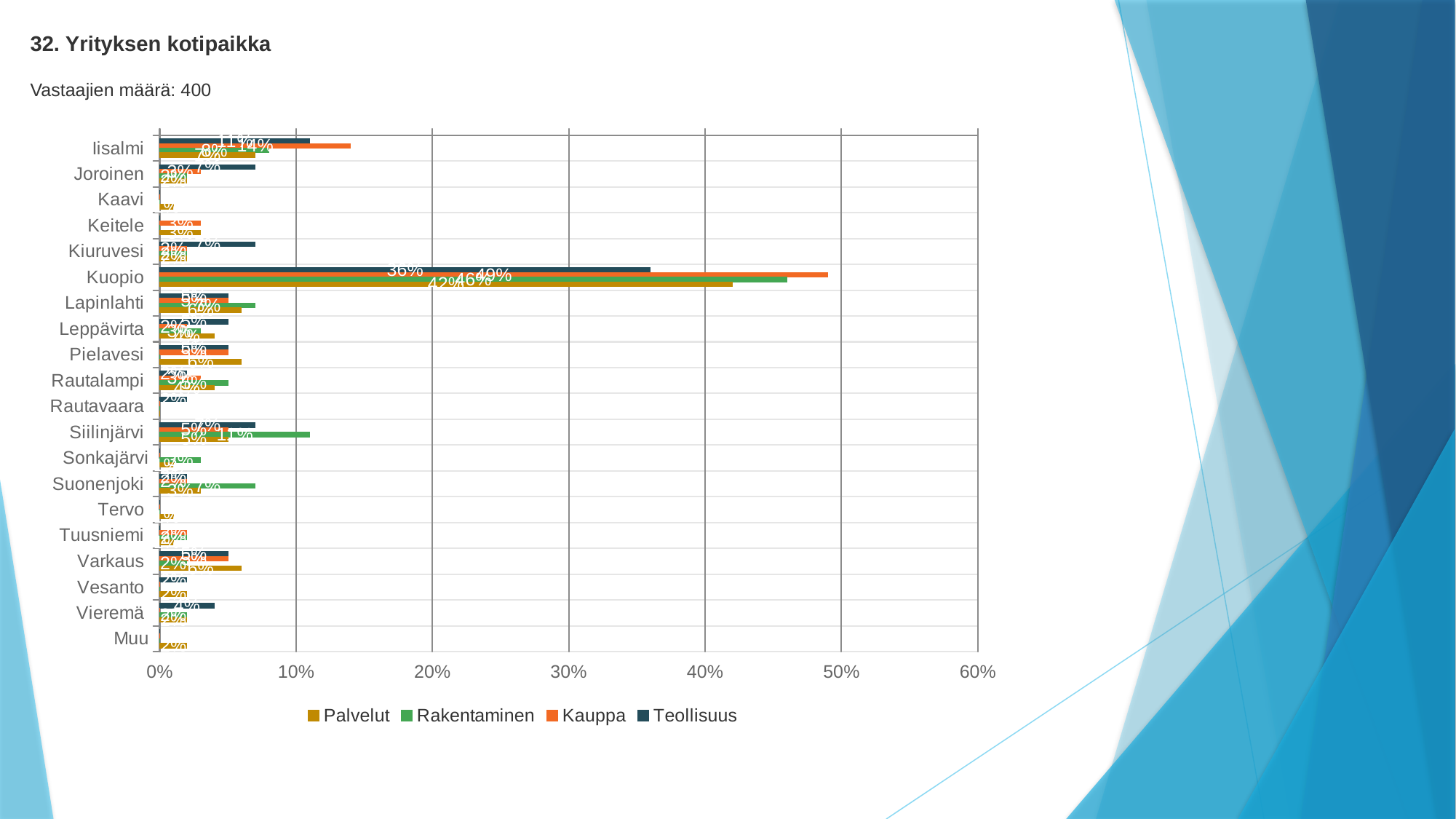
What is the Teollisuus value for Kuopio? 36% What is the Palvelut value for Kuopio? 42% What kind of chart is shown on the slide? bar chart What is the Kauppa value for Kuopio? 49% How many series does the legend list? 4 Is the Kauppa value for Kuopio greater or less than 40%? greater What is the difference between the Kauppa and Teollisuus values for Kuopio? 13% Which series is shown in orange in the legend? Kauppa How many municipalities (categories) are listed on the vertical axis? 20 What is the Rakentaminen value for Kuopio? 46% Which municipality has the highest values across all series? Kuopio What is the Kauppa value for Iisalmi? 14%